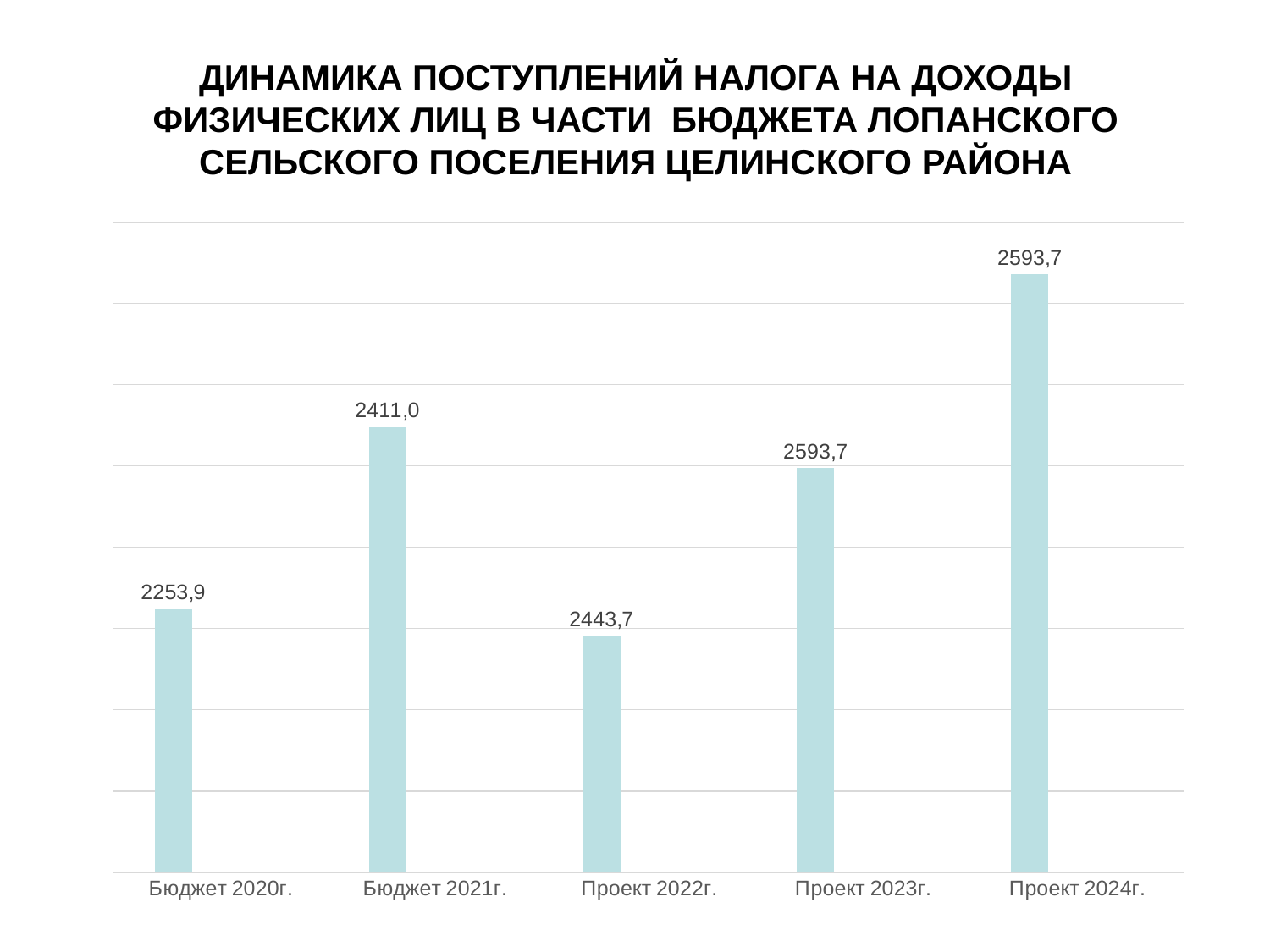
How many categories are shown on the x axis? 5 What is the difference between the values for Проект 2024г. and Бюджет 2020г.? 339,8 What is the difference between the values for Бюджет 2021г. and Бюджет 2020г.? 157,1 What is the value for Бюджет 2021г.? 2411,0 What is the title of the chart? ДИНАМИКА ПОСТУПЛЕНИЙ НАЛОГА НА ДОХОДЫ ФИЗИЧЕСКИХ ЛИЦ В ЧАСТИ БЮДЖЕТА ЛОПАНСКОГО СЕЛЬСКОГО ПОСЕЛЕНИЯ ЦЕЛИНСКОГО РАЙОНА What is the value for Проект 2024г.? 2593,7 What kind of chart is shown on the slide? Bar chart What is the value for Проект 2023г.? 2593,7 What is the value for Бюджет 2020г.? 2253,9 Which is larger, the value for Проект 2023г. or the value for Бюджет 2020г.? Проект 2023г. What is the value for Проект 2022г.? 2443,7